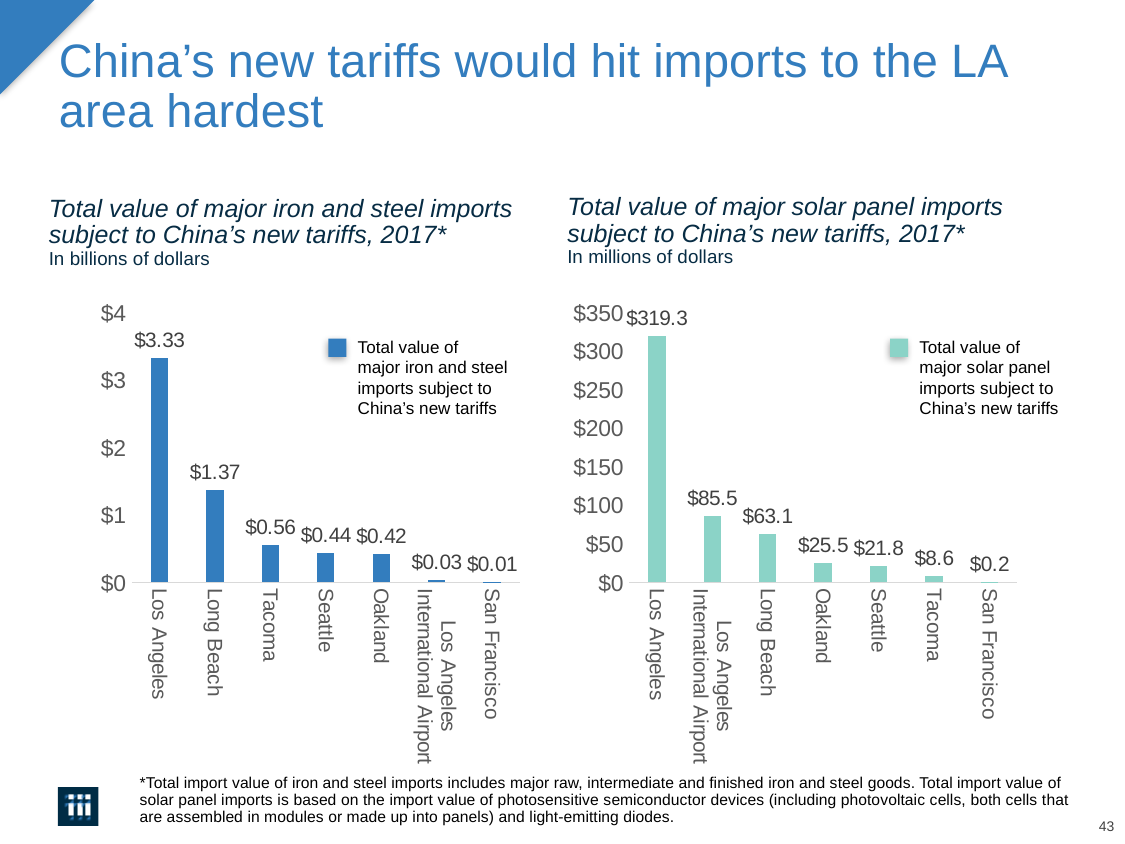
In the solar panel imports chart, is the value for Los Angeles greater or less than $300? greater In the solar panel imports chart, do the values rise or fall from left to right? Fall In what units are the values in the solar panel imports chart expressed? Millions of dollars What kind of chart is the solar panel imports chart? Bar chart In the solar panel imports chart, what is the difference between Long Beach and Oakland? $37.6 In the solar panel imports chart, what is the value for Los Angeles International Airport? $85.5 How many ports are shown in the iron and steel imports chart? 7 In the iron and steel imports chart, what is the difference between Los Angeles and Long Beach? $1.96 In the iron and steel imports chart, which port has the lowest value? San Francisco In the iron and steel imports chart, what is the value for Los Angeles? $3.33 In the iron and steel imports chart, which is larger, Tacoma or Seattle? Tacoma In the solar panel imports chart, which port has the highest value? Los Angeles